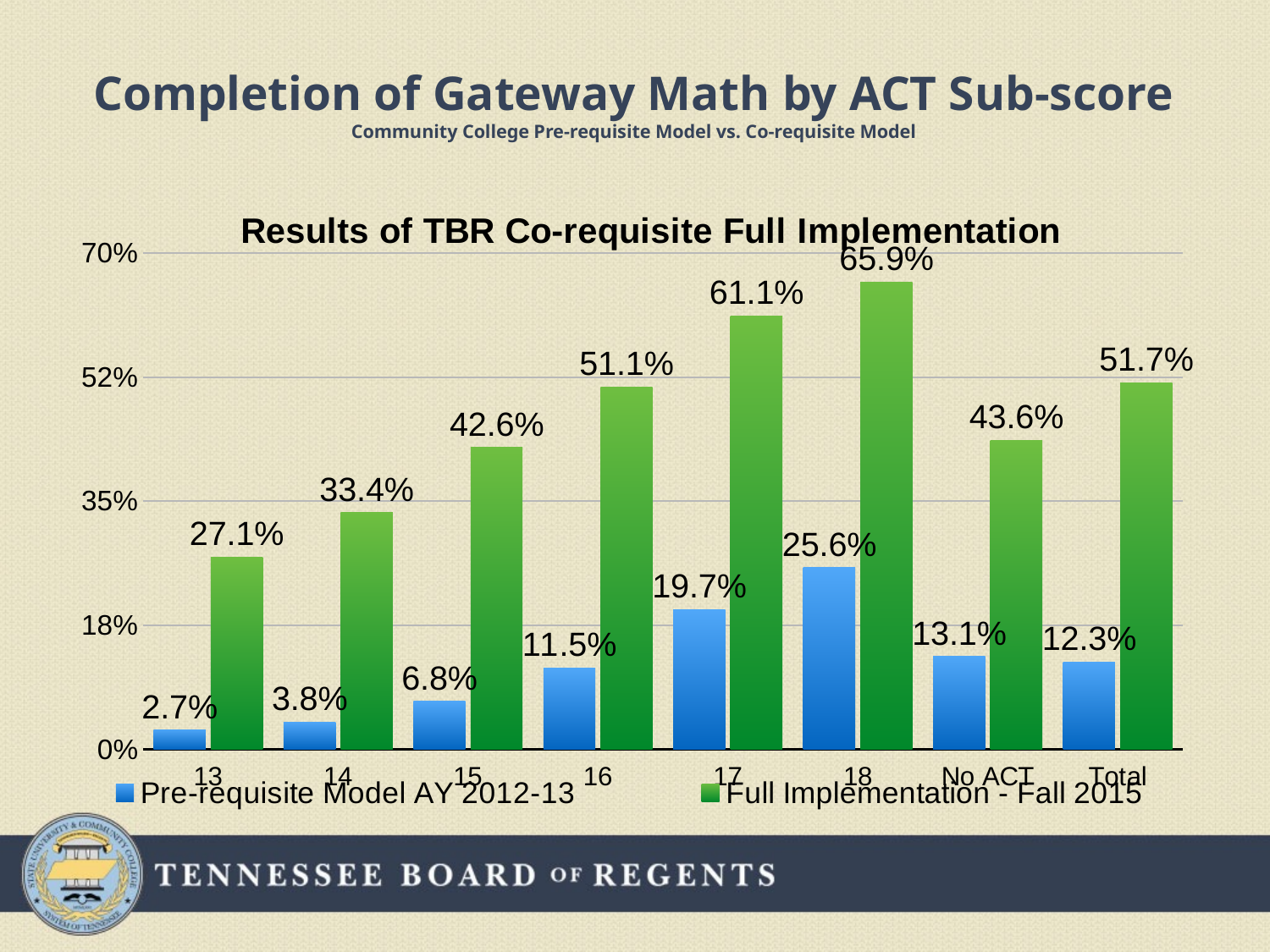
Is the Full Implementation - Fall 2015 value for ACT sub-score 15 greater or less than 35%? greater What is the difference between the Full Implementation - Fall 2015 and Pre-requisite Model AY 2012-13 values for ACT sub-score 16? 39.6% What is the Full Implementation - Fall 2015 value for ACT sub-score 17? 61.1% Do the Full Implementation - Fall 2015 values rise or fall from ACT sub-score 13 to 18? Rise Which category has the highest Full Implementation - Fall 2015 value? 18 How many series does the legend list? 2 Which category has the lowest Pre-requisite Model AY 2012-13 value? 13 What is the Pre-requisite Model AY 2012-13 value for the No ACT category? 13.1% What is the Pre-requisite Model AY 2012-13 value for the Total category? 12.3% Which is larger: the Pre-requisite Model AY 2012-13 value for 18 or for No ACT? 18 What kind of chart is shown on the slide? Bar chart How many categories are shown on the x axis? 8